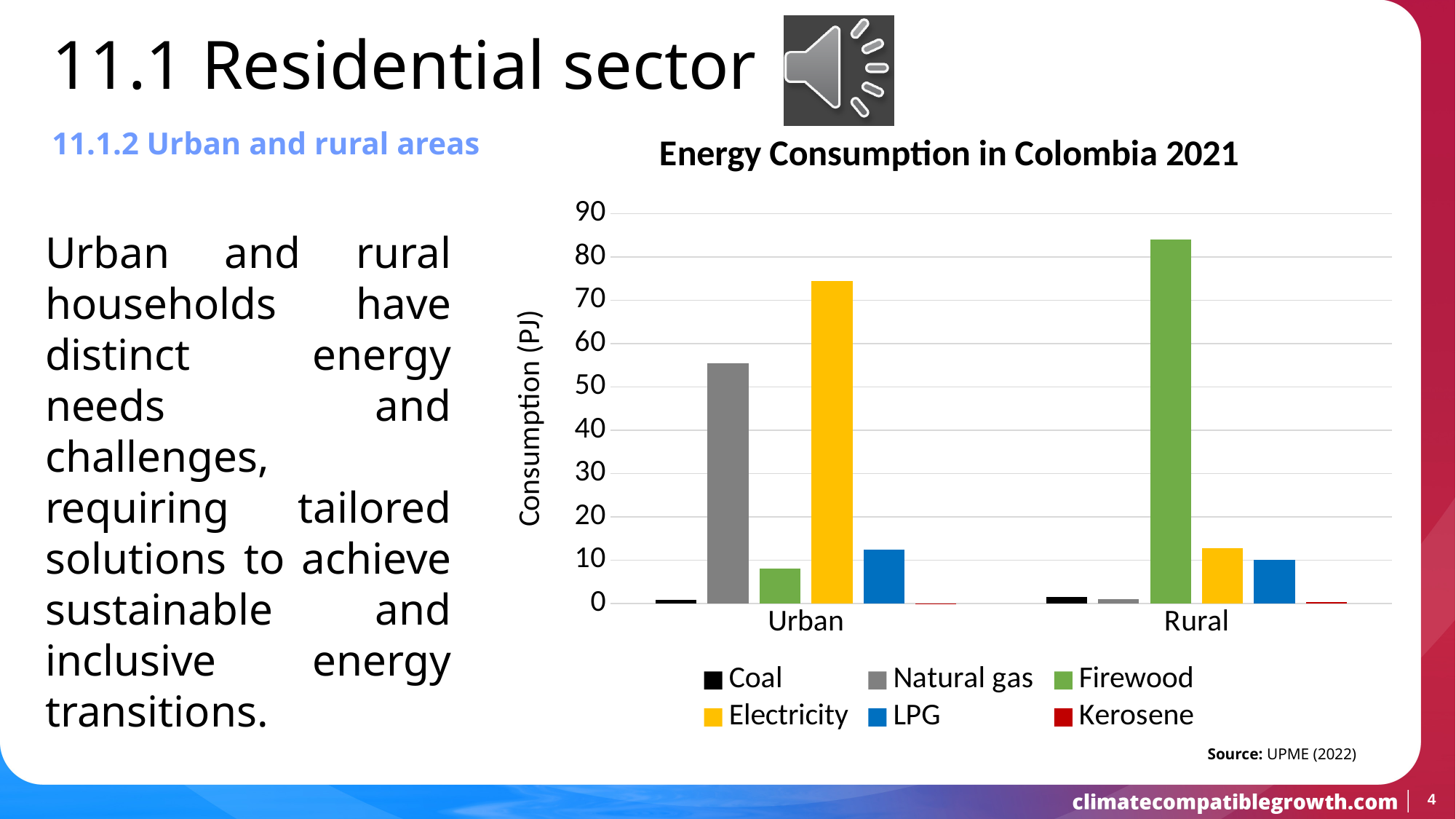
Which energy source has the highest consumption in the Urban category? Electricity Is the value for Firewood in the Rural category greater or less than 80? greater Is the value for Natural gas in the Urban category greater or less than 60? less What is the label of the vertical axis of the chart? Consumption (PJ) What is the title of the chart? Energy Consumption in Colombia 2021 Which is larger: Firewood consumption in Rural or Electricity consumption in Urban? Firewood in Rural How many categories are shown on the x axis of the chart? 2 What kind of chart is shown on the slide? bar chart How many series does the legend of the chart list? 6 Is the value for Electricity in the Urban category greater or less than 70? greater Which category has the larger Natural gas consumption, Urban or Rural? Urban Which energy source has the highest consumption in the Rural category? Firewood